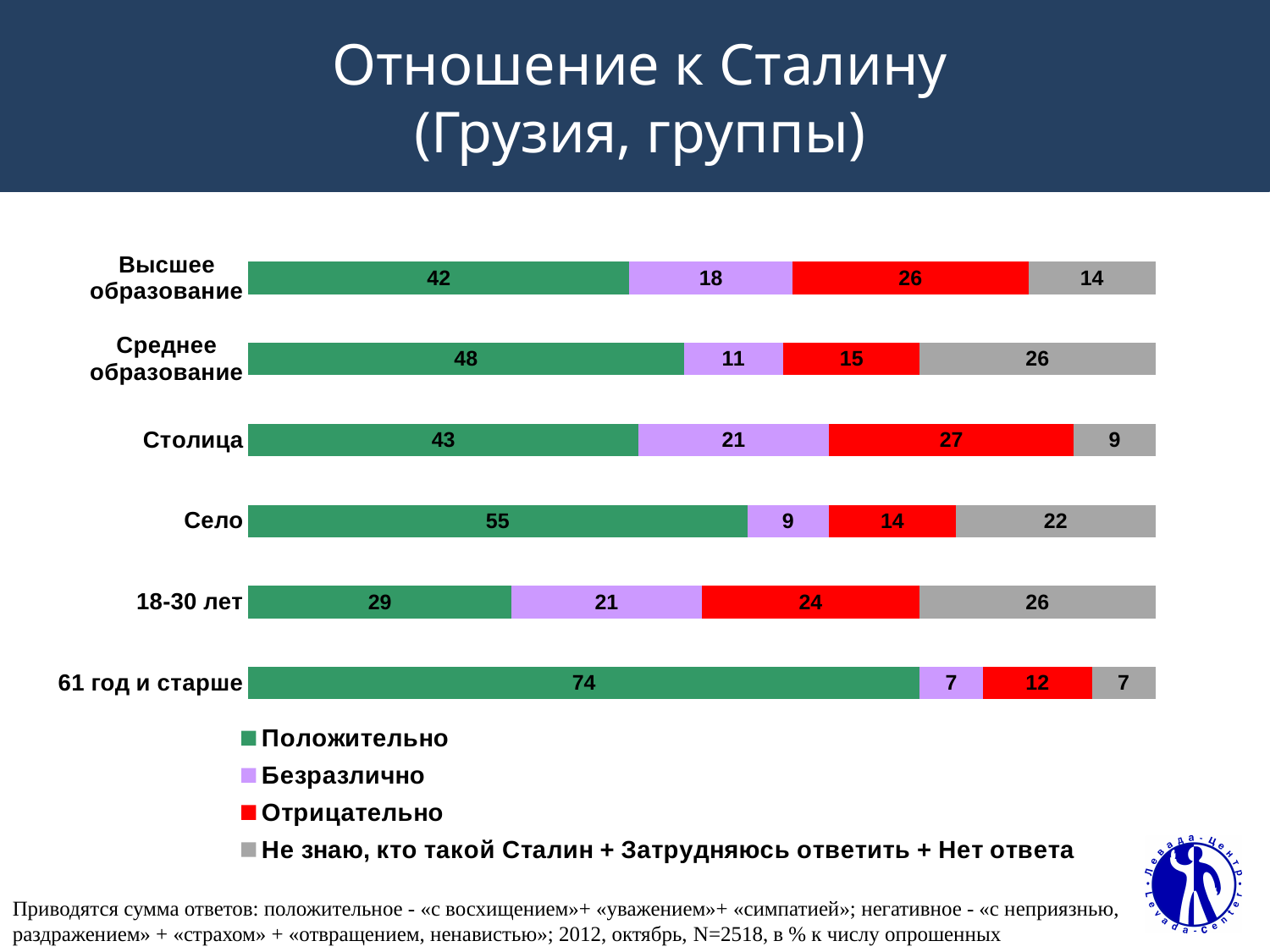
How many series does the legend list? 4 What is the value for Безразлично in the Среднее образование category? 11 What is the value for Положительно in the Село category? 55 How many categories are shown in the chart? 6 Which category has the lowest value for Положительно? 18-30 лет What is the difference between the Положительно values for 61 год и старше and 18-30 лет? 45 Which has a larger Отрицательно value: Высшее образование or Среднее образование? Высшее образование What kind of chart is shown on the slide? Stacked bar chart What is the total of the stacked bar for Столица? 100 What is the difference between the 'Не знаю, кто такой Сталин + Затрудняюсь ответить + Нет ответа' values for Среднее образование and Высшее образование? 12 Which category has the highest value for Положительно? 61 год и старше What is the value for Отрицательно in the Столица category? 27